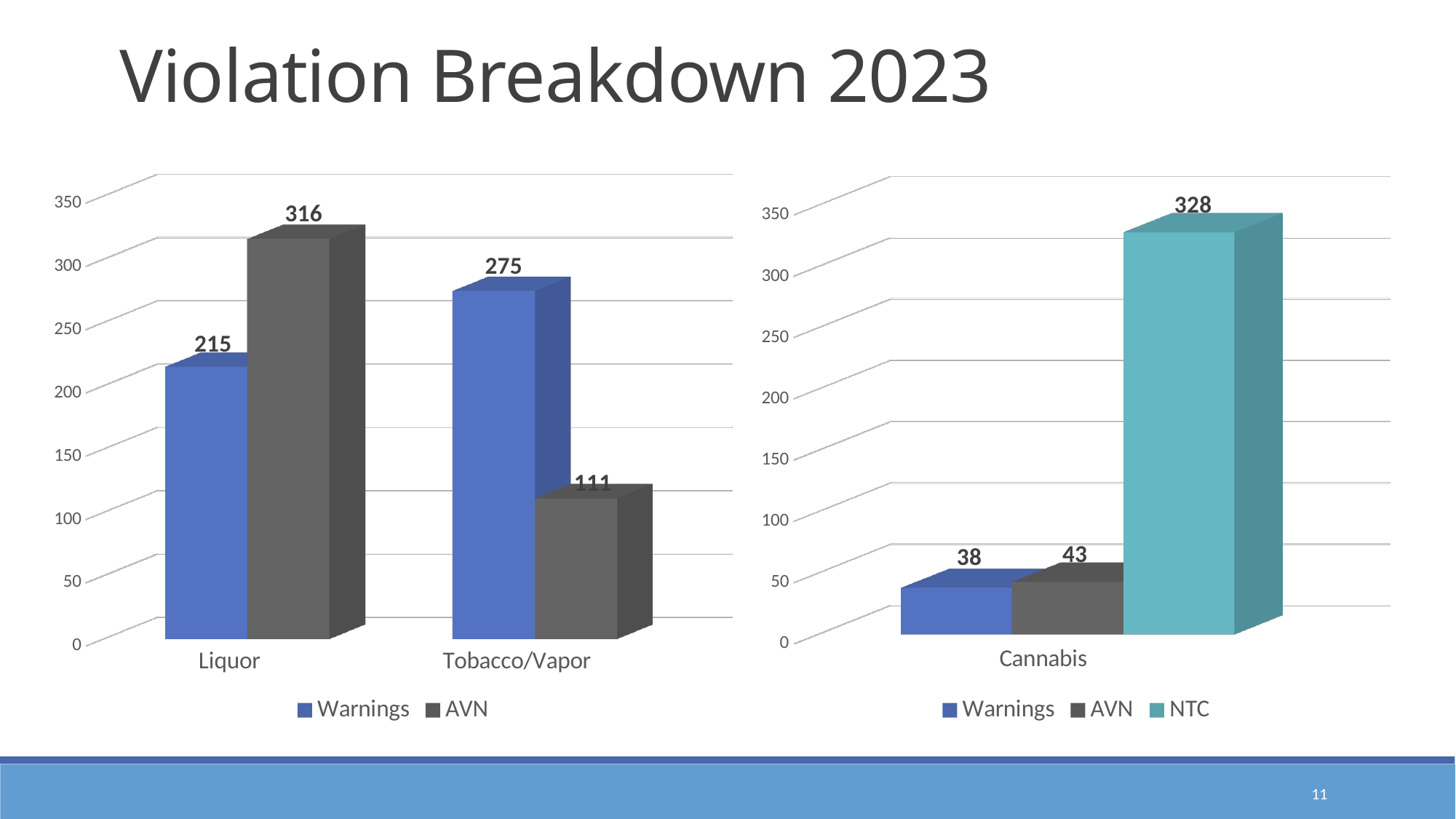
How many categories are shown on the x axis of the left chart? 2 In the left chart, what is the Warnings value for Liquor? 215 In the left chart, which category has the higher AVN value? Liquor In the left chart, what is the difference between the AVN and Warnings values for Liquor? 101 In the right chart, what is the NTC value for Cannabis? 328 How many series does the legend of the right chart list? 3 What kind of chart is the left chart? Bar chart What is the title of the slide? Violation Breakdown 2023 In the right chart, which series has the lowest value for Cannabis? Warnings In the right chart, what is the difference between the AVN and Warnings values for Cannabis? 5 In the left chart, what is the AVN value for Tobacco/Vapor? 111 In the left chart, which is larger: Warnings for Tobacco/Vapor or Warnings for Liquor? Warnings for Tobacco/Vapor